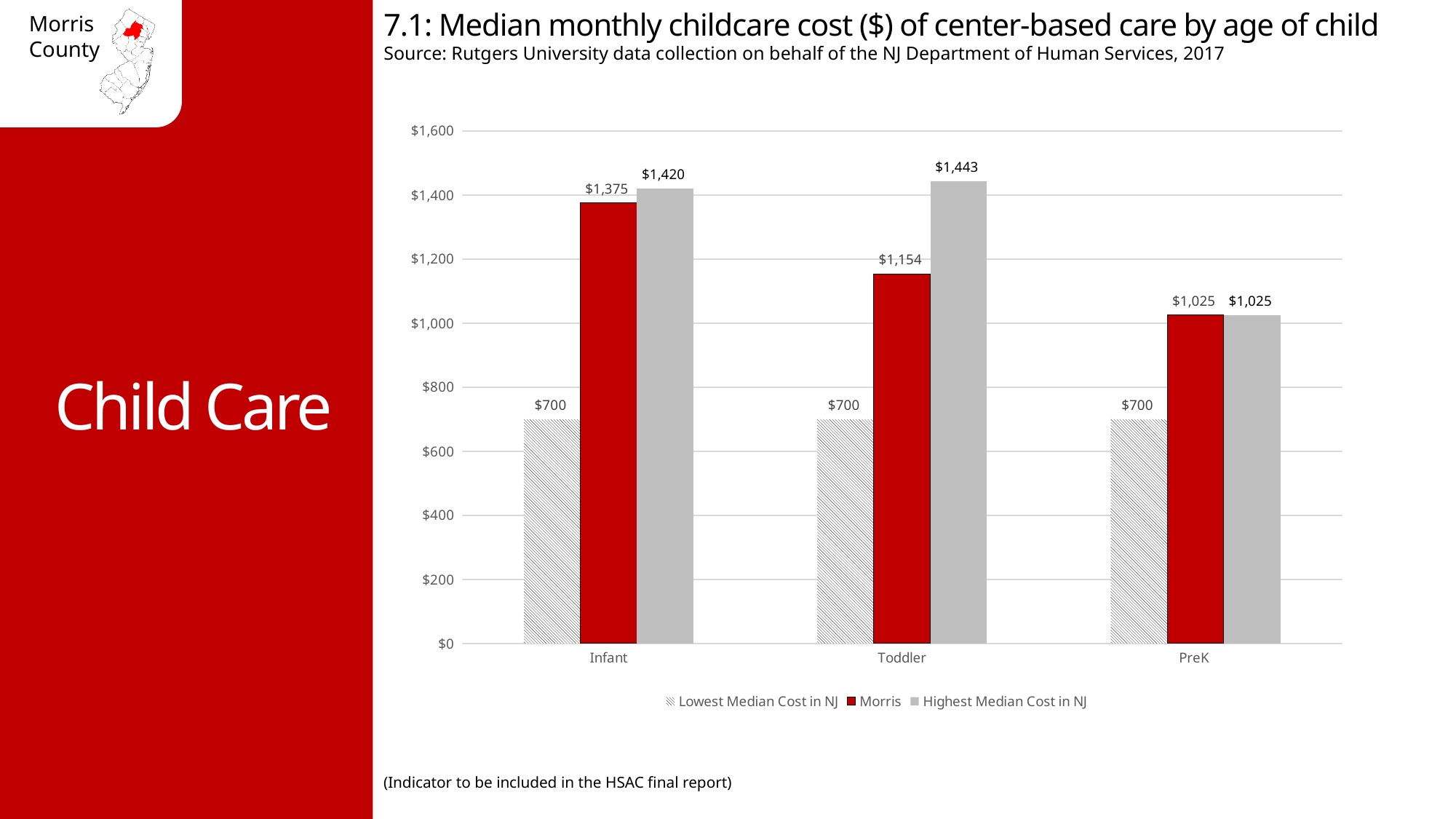
What is the Highest Median Cost in NJ for Toddler? $1,443 What is the Morris value for Infant? $1,375 Is the Morris value for Toddler greater or less than $1,000? greater How many age groups are shown on the x axis? 3 Do the Morris values rise or fall from Infant to PreK? Fall Which age group has the highest Morris value? Infant How many series does the legend list? 3 Which age group has the lowest Highest Median Cost in NJ value? PreK What is the Lowest Median Cost in NJ for PreK? $700 Which is larger for Infant: the Morris value or the Highest Median Cost in NJ? Highest Median Cost in NJ What kind of chart is shown? Bar chart What is the difference between the Highest Median Cost in NJ and the Morris value for Toddler? $289